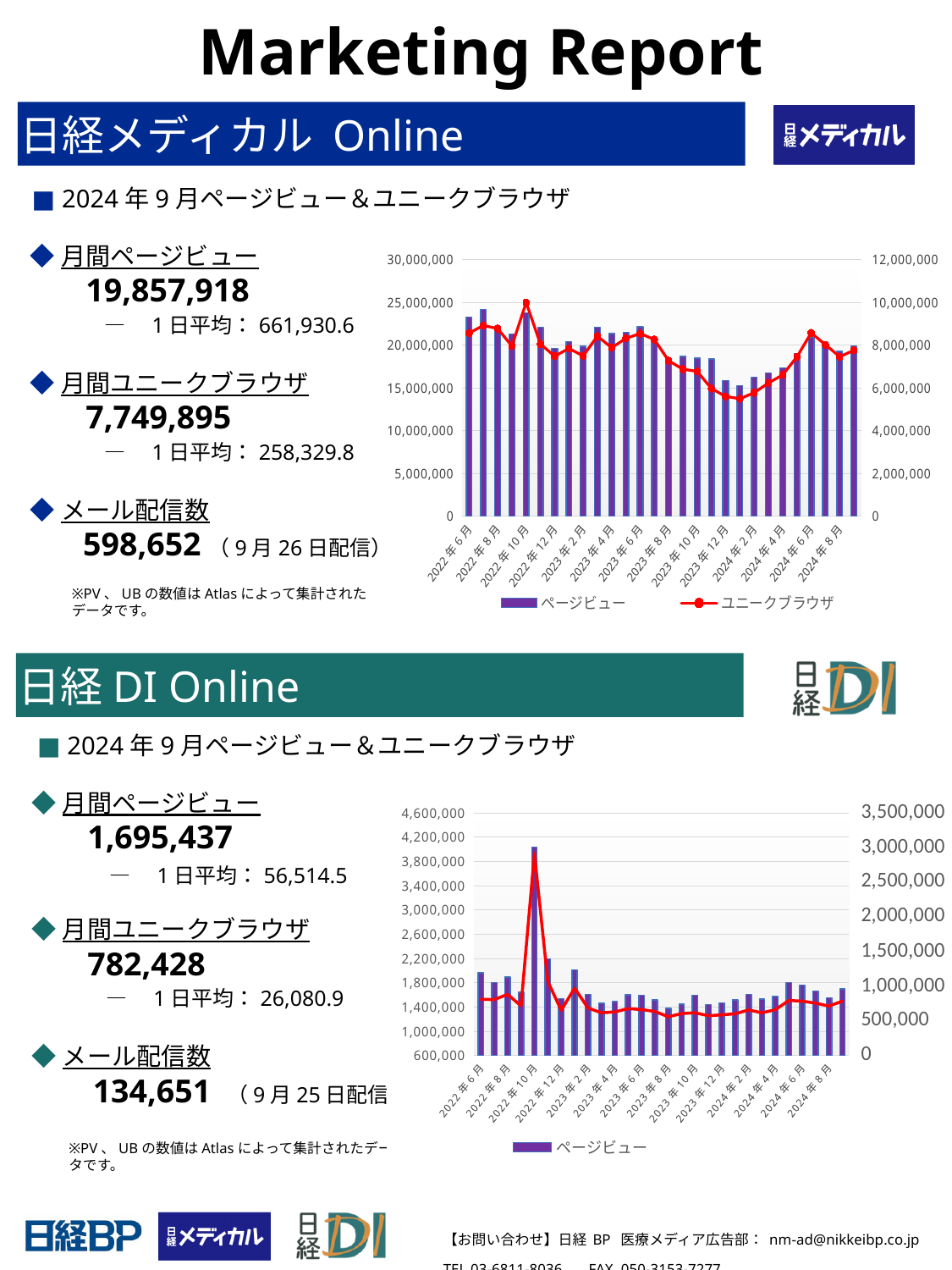
In the 日経メディカル Online chart, do the ページビュー bars rise or fall from 2023年6月 to 2023年12月? fall In the 日経メディカル Online chart, is the ユニークブラウザ value for 2024年2月 greater or less than 8,000,000? less What colour is the ユニークブラウザ line in the 日経メディカル Online chart? Red In the 日経 DI Online chart, is the ページビュー value for 2022年10月 greater or less than 3,000,000? greater How many series does the legend of the 日経メディカル Online chart list? 2 In the 日経メディカル Online chart, which month has the highest ユニークブラウザ value? 2022年10月 What kind of chart is shown in the 日経メディカル Online section? Combined bar and line chart In the 日経 DI Online chart, is the ページビュー value for 2023年4月 greater or less than 2,200,000? less In the 日経 DI Online chart, which series is listed in the legend? ページビュー In the 日経 DI Online chart, which month has the highest ページビュー bar? 2022年10月